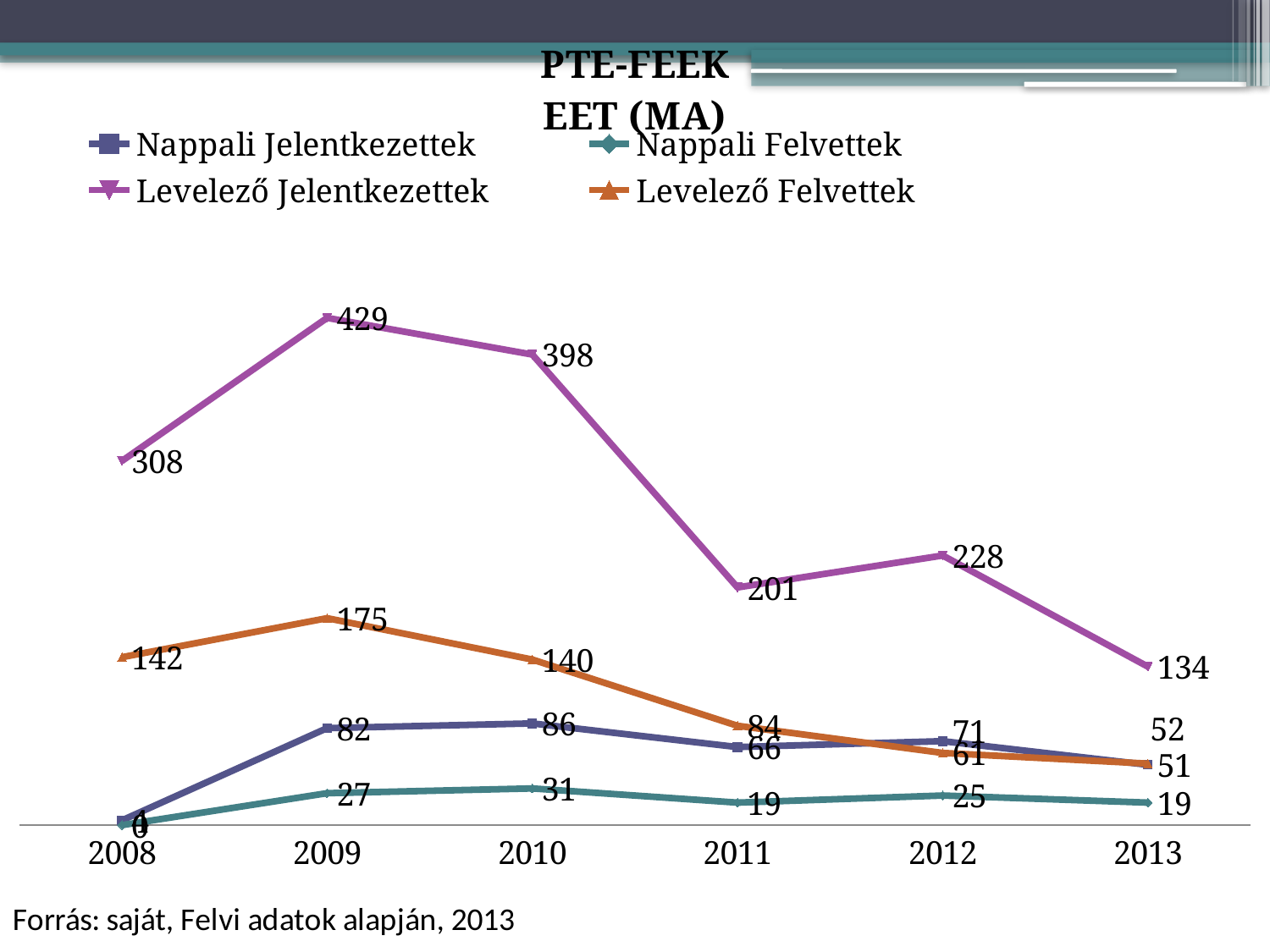
What is the value for Nappali Jelentkezettek in 2010? 86 How many years are shown on the x axis? 6 What type of chart is shown on the slide? line chart What is the value for Levelező Felvettek in 2011? 84 How many series does the legend list? 4 In which year is Levelező Jelentkezettek highest? 2009 What is the value for Levelező Jelentkezettek in 2009? 429 Which is larger in 2012: Nappali Jelentkezettek or Levelező Felvettek? Nappali Jelentkezettek What is the value for Nappali Felvettek in 2013? 19 What is the difference between Levelező Jelentkezettek in 2010 and in 2011? 197 In which year is Levelező Felvettek lowest? 2013 Does Levelező Jelentkezettek rise or fall from 2010 to 2013 overall? fall